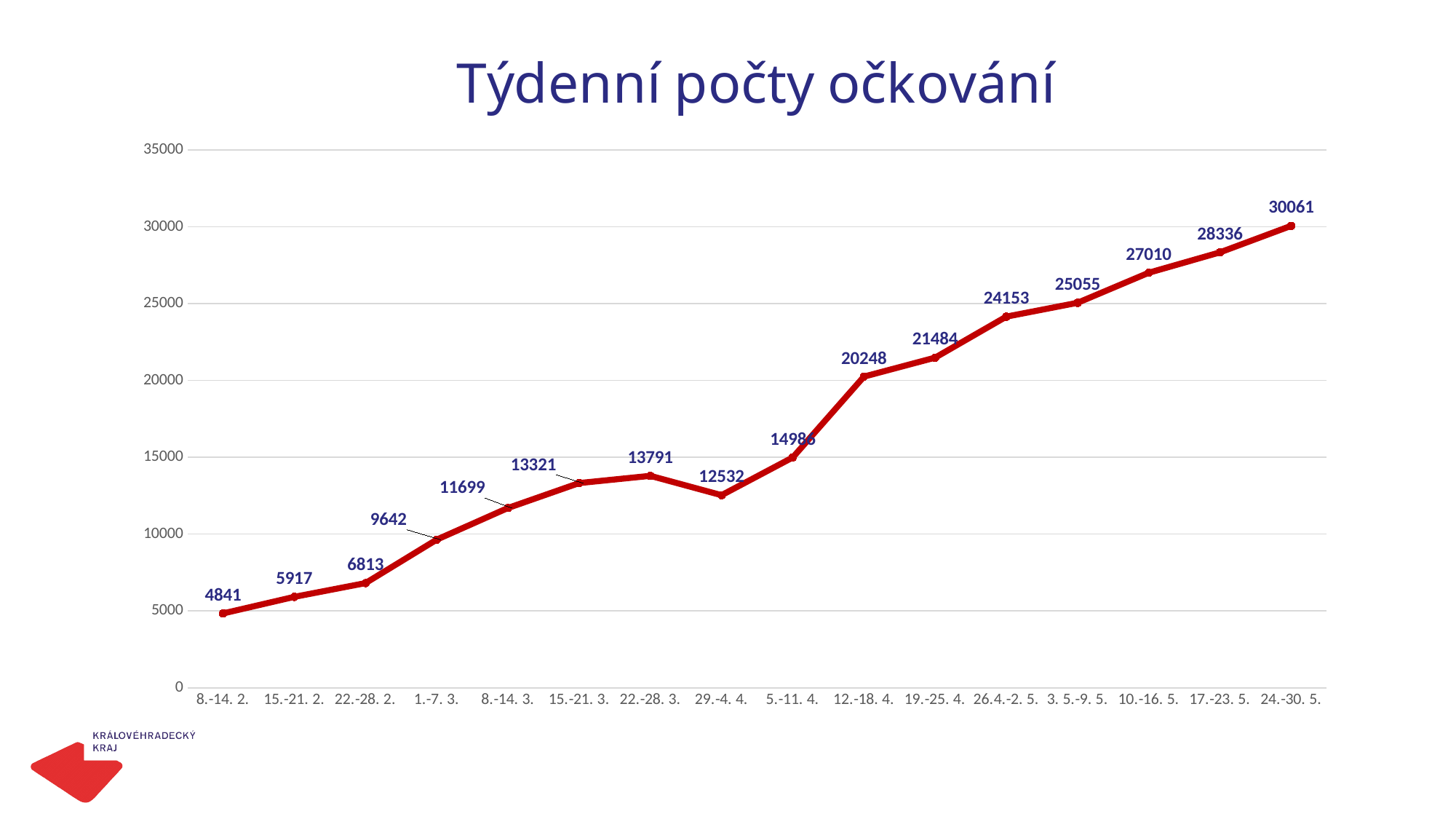
Which week has the highest value? 24.-30. 5. What is the difference between the values for 24.-30. 5. and 17.-23. 5.? 1725 Which is larger, the value for 22.-28. 3. or the value for 29.-4. 4.? 22.-28. 3. What is the value for the week 1.-7. 3.? 9642 Is the value for 19.-25. 4. greater or less than 20000? greater What is the value for the week 12.-18. 4.? 20248 What is the value for the week 8.-14. 2.? 4841 What type of chart is shown on the slide? line chart How many weeks are plotted on the chart? 16 What is the value for the week 24.-30. 5.? 30061 Which week has the lowest value? 8.-14. 2. What is the difference between the values for 22.-28. 3. and 29.-4. 4.? 1259